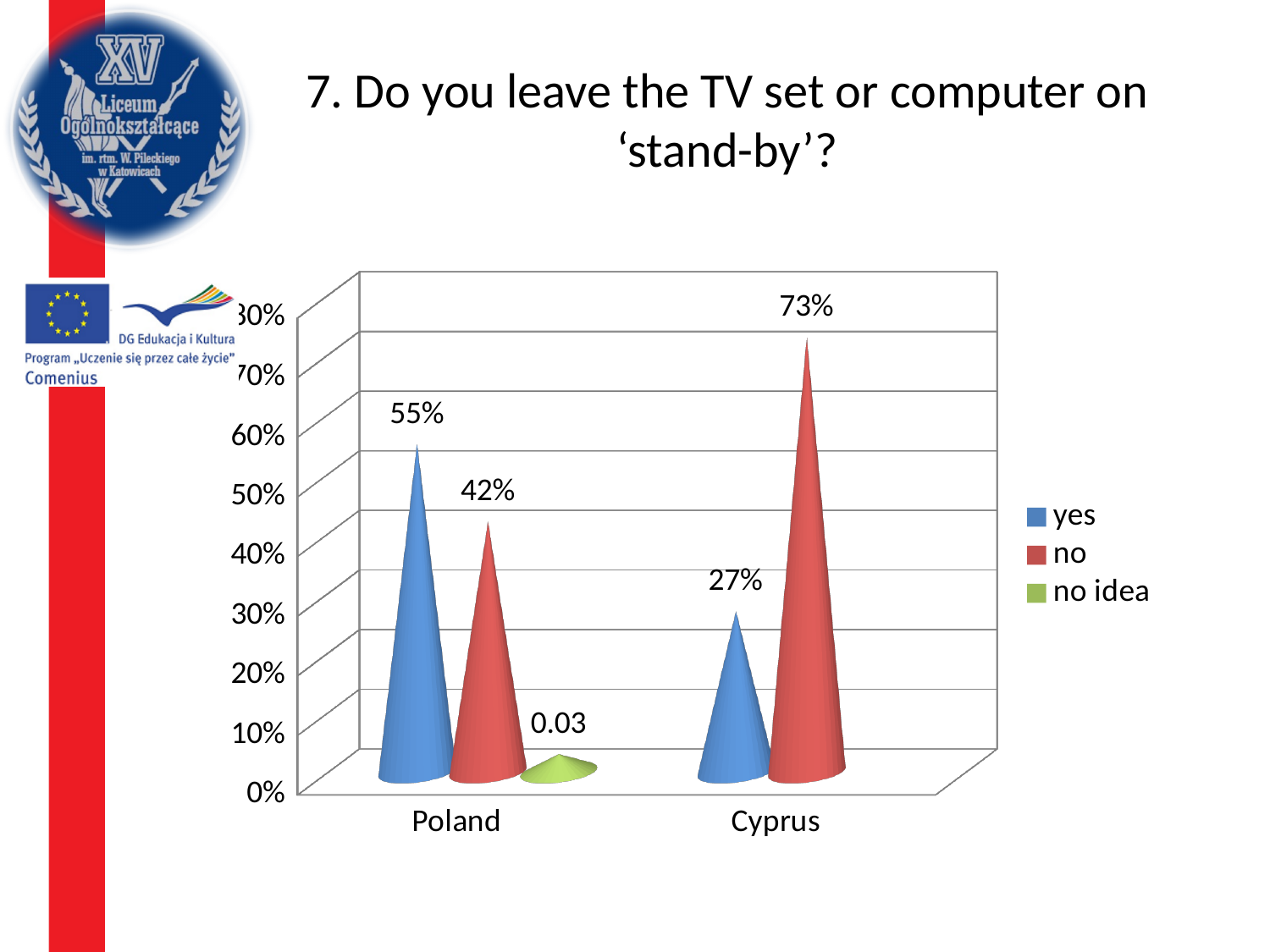
What value is shown for 'no idea' in Poland? 0.03 What colour represents the 'no' series in the legend? Red Which series has the highest value in the chart? no (Cyprus) Which country has the higher 'yes' value? Poland How many series does the legend list? 3 What percentage of respondents in Poland answered 'yes'? 55% How many countries are shown on the x axis? 2 What percentage of respondents in Cyprus answered 'no'? 73% Which country has the higher 'no' value? Cyprus What is the difference between the 'yes' and 'no' values for Poland? 13% What is the difference between the 'no' values for Cyprus and Poland? 31% What percentage of respondents in Cyprus answered 'yes'? 27%